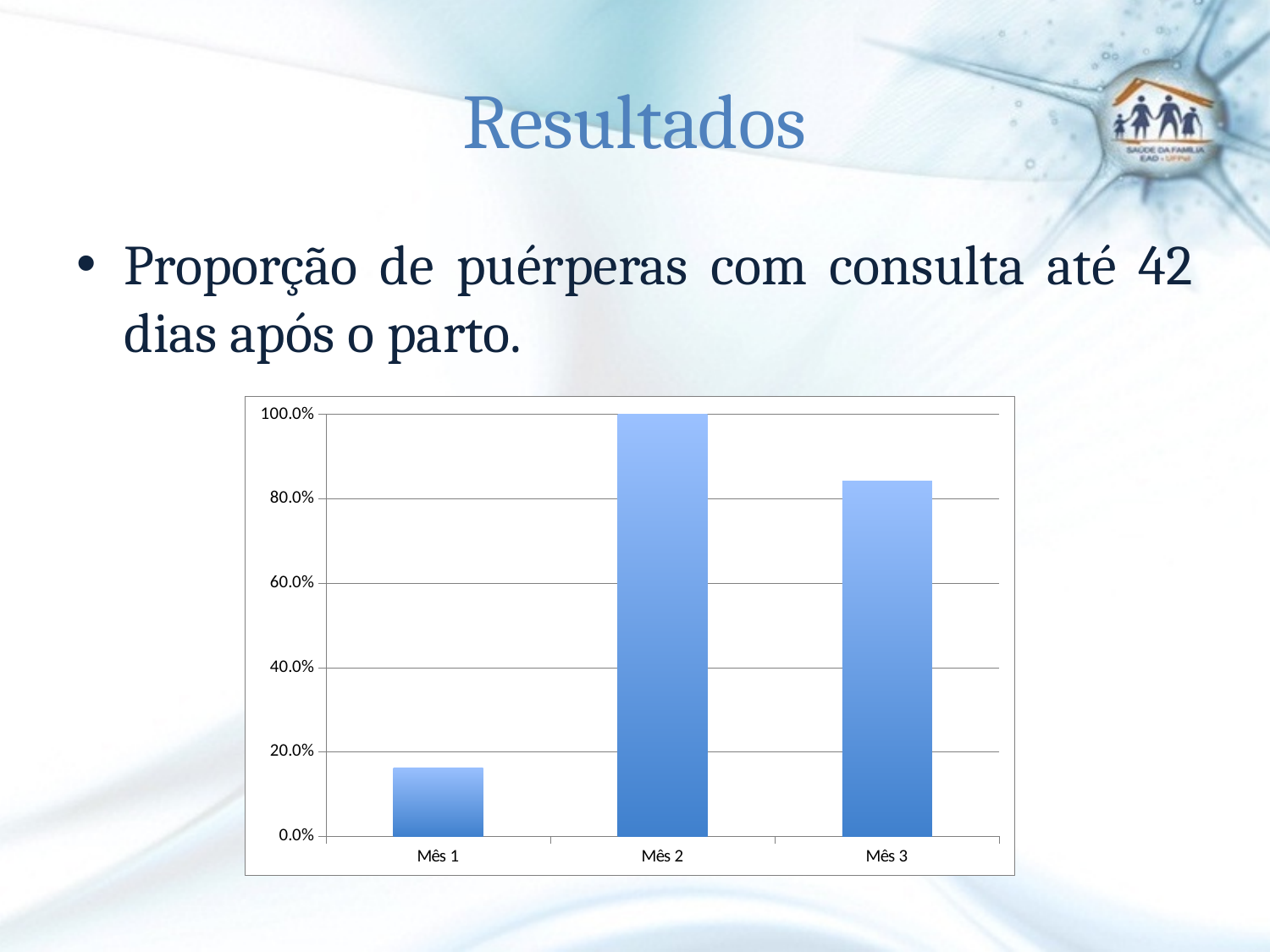
Does the value rise or fall from Mês 2 to Mês 3? fall Which month has the highest value in the chart? Mês 2 Which month has the lowest value in the chart? Mês 1 What is the highest tick label shown on the y axis of the chart? 100.0% How many categories are plotted on the x axis of the chart? 3 Does the value rise or fall from Mês 1 to Mês 2? rise Is the value for Mês 3 greater or less than 80.0%? greater What is the value for Mês 2 in the chart? 100.0% Is the value for Mês 1 greater or less than 40.0%? less Which is larger, the value for Mês 3 or the value for Mês 1? Mês 3 What kind of chart is shown on the slide? bar chart Is the value for Mês 1 greater or less than 20.0%? less